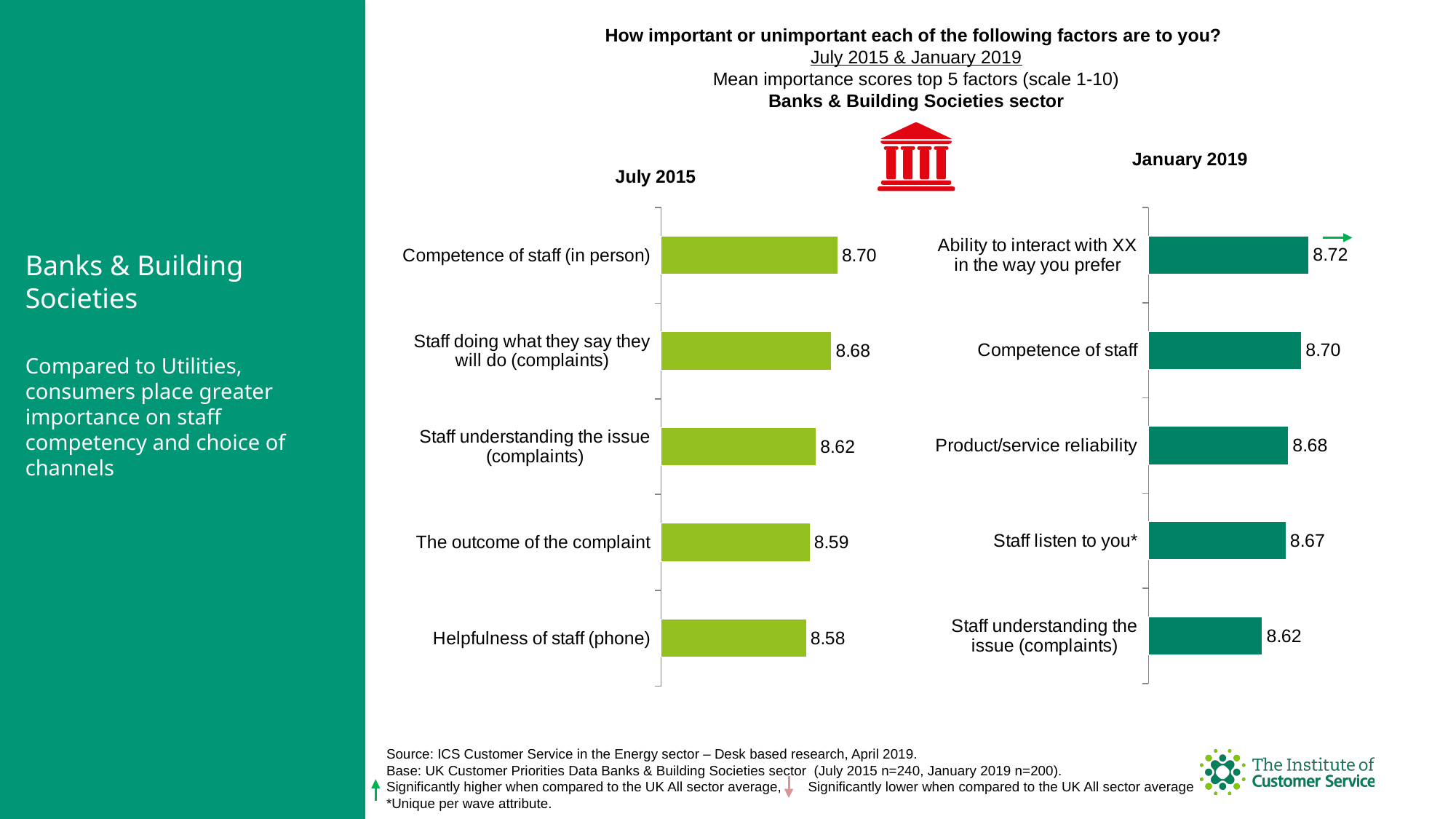
In the January 2019 chart, what is the difference between the scores for Ability to interact with XX in the way you prefer and Staff understanding the issue (complaints)? 0.10 In the January 2019 chart, what is the mean importance score for Product/service reliability? 8.68 In the July 2015 chart, what is the mean importance score for Competence of staff (in person)? 8.70 In the July 2015 chart, which factor has the lowest mean importance score? Helpfulness of staff (phone) What type of chart is used to show the January 2019 scores? Bar chart In the July 2015 chart, which factor has the highest mean importance score? Competence of staff (in person) In the January 2019 chart, what is the score for Staff listen to you*? 8.67 In the January 2019 chart, which factor has the highest score? Ability to interact with XX in the way you prefer Which is larger: the July 2015 score for The outcome of the complaint or the January 2019 score for Competence of staff? January 2019 Competence of staff In the July 2015 chart, what is the difference between the scores for Competence of staff (in person) and Helpfulness of staff (phone)? 0.12 In the January 2019 chart, which factor has the lowest score? Staff understanding the issue (complaints) How many factors are shown in the July 2015 chart? 5